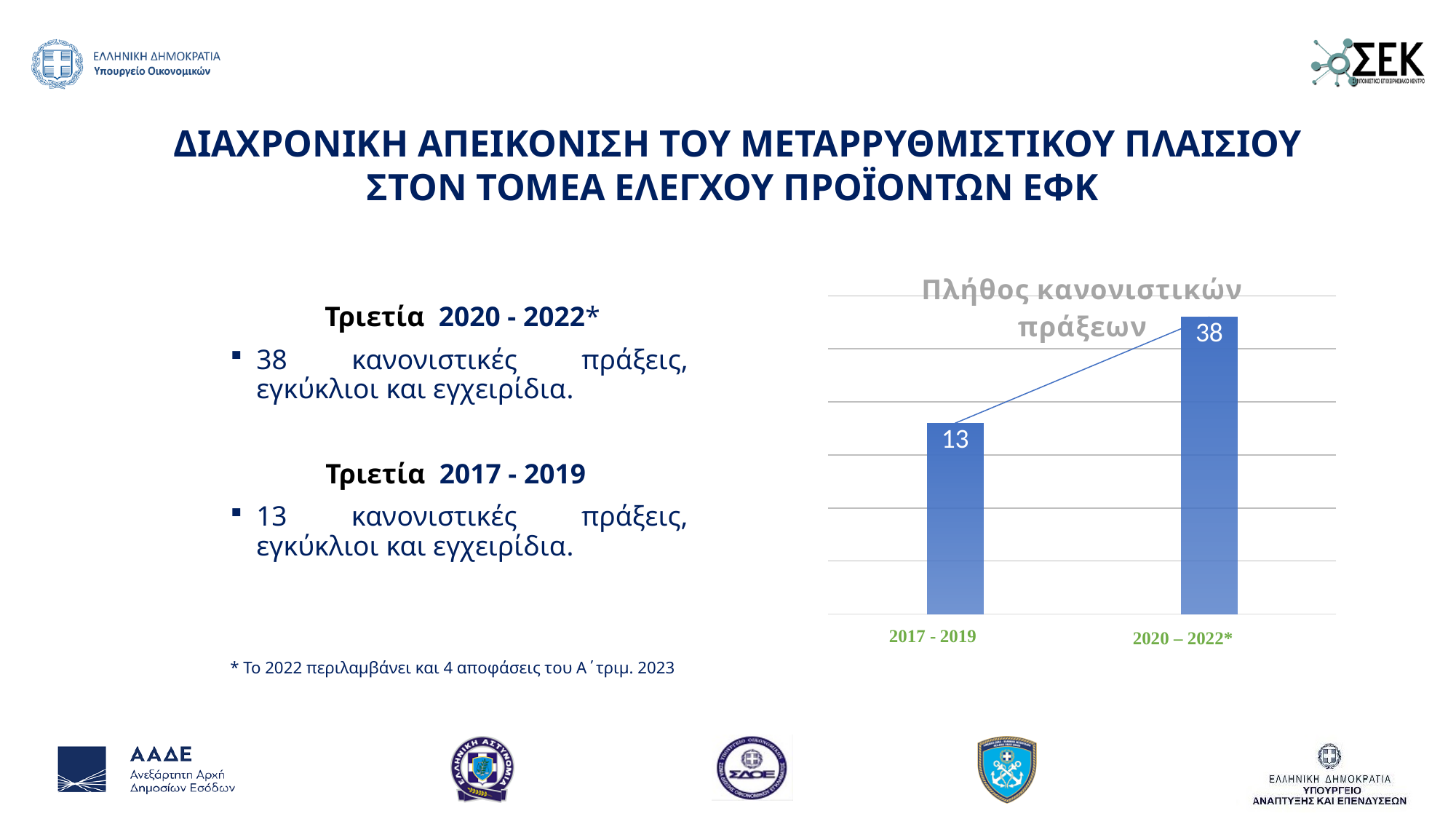
What is the value for 2017 - 2019 in the chart? 13 What colour are the bars in the chart? blue How many categories are shown in the chart? 2 Which period has the lowest value in the chart? 2017 - 2019 What is the value for 2020 – 2022* in the chart? 38 What is the difference between the values for 2020 – 2022* and 2017 - 2019? 25 Do the values rise or fall from 2017 - 2019 to 2020 – 2022*? rise Which is larger, the value for 2017 - 2019 or the value for 2020 – 2022*? 2020 – 2022* What kind of chart is shown on the slide? bar chart What is the title of the chart? Πλήθος κανονιστικών πράξεων Which period has the highest value in the chart? 2020 – 2022*